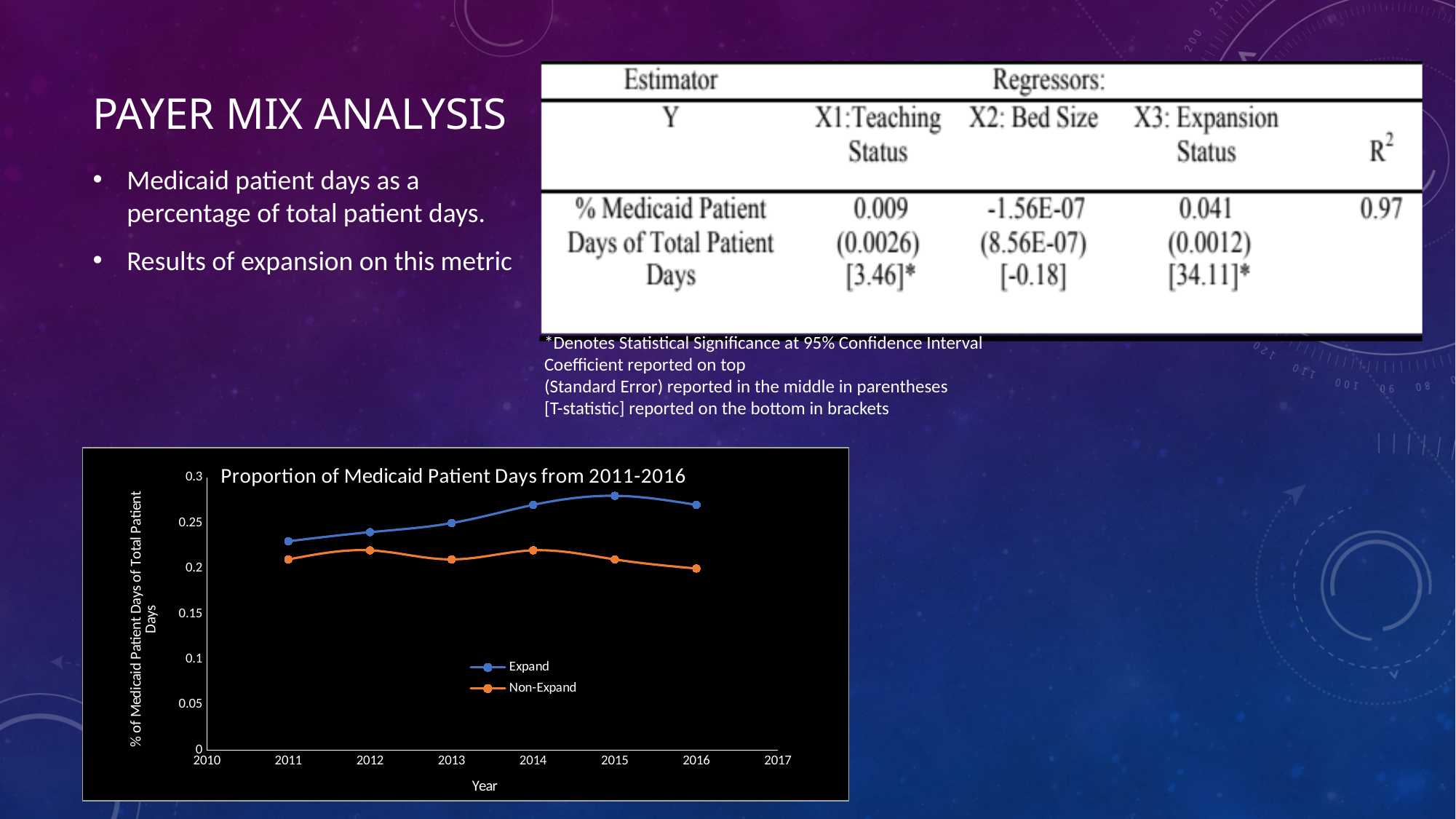
In which year does the Expand series reach its highest value? 2015 In which year does the Expand series have its lowest value? 2011 Is the value for Expand in 2015 greater or less than 0.25? greater How many series does the legend of the chart list? 2 What kind of chart is shown on the slide? line chart Does the Expand series rise or fall from 2011 to 2015? rise In 2014, which series has the larger value, Expand or Non-Expand? Expand Is the value for Non-Expand in 2011 greater or less than 0.15? greater How many years are plotted for each series in the chart? 6 Is the value for Expand in 2011 greater or less than 0.25? less What is the title of the chart? Proportion of Medicaid Patient Days from 2011-2016